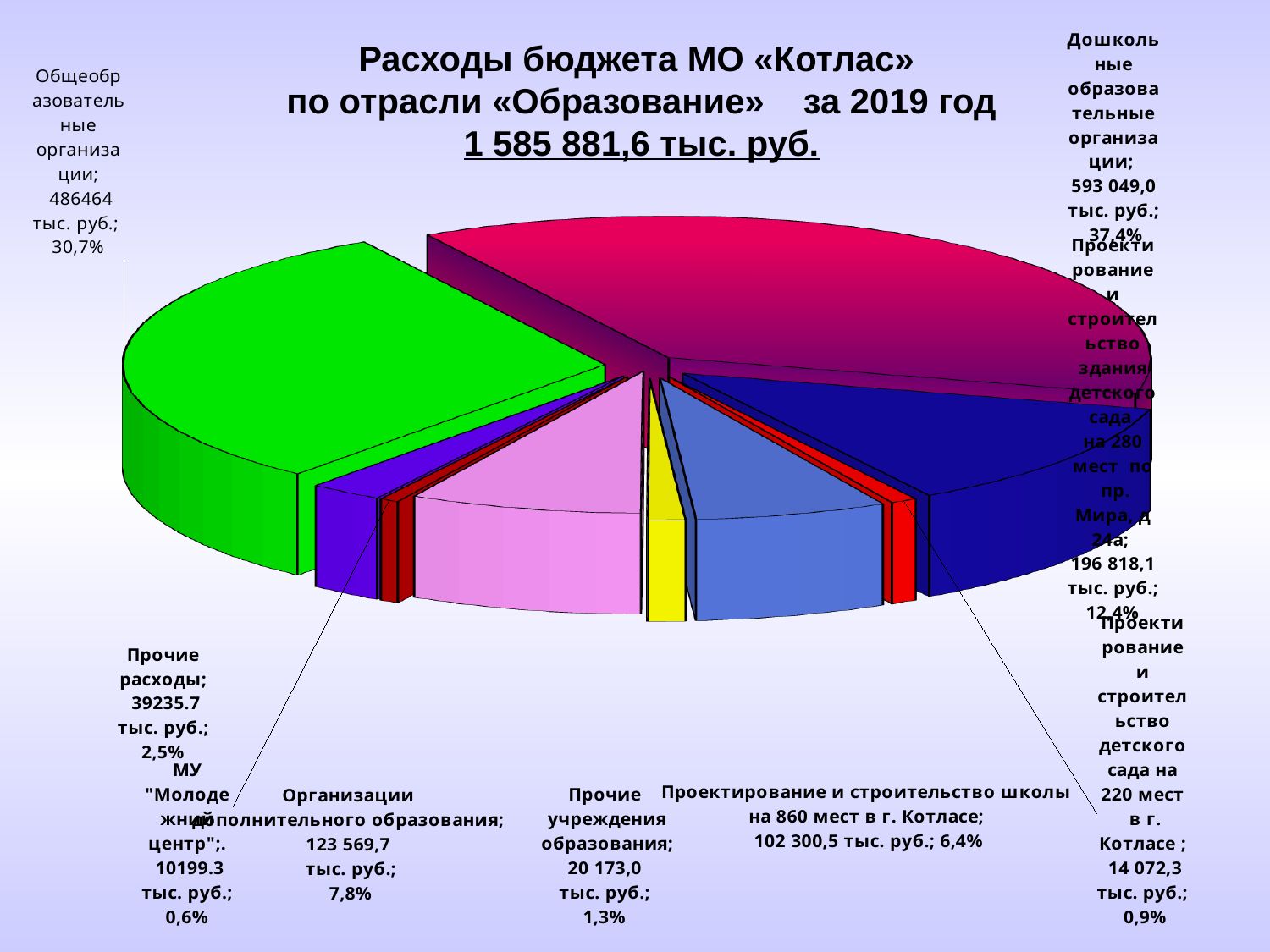
What share of the pie does «Общеобразовательные организации» represent? 30,7% What total amount is stated in the chart title? 1 585 881,6 тыс. руб. What is the value for «Организации дополнительного образования»? 123 569,7 тыс. руб. What is the difference in percentage points between «Дошкольные образовательные организации» (37,4%) and «Общеобразовательные организации» (30,7%)? 6,7 Which category has the smallest share of the pie? МУ "Молодежний центр" What kind of chart is shown on the slide? pie chart Which is larger: the share for «Прочие расходы» or the share for «Прочие учреждения образования»? Прочие расходы How many slices does the pie chart have? 9 What percentage is shown for «Проектирование и строительство школы на 860 мест в г. Котласе»? 6,4% Which category has the largest share of the pie? Дошкольные образовательные организации What is the value for «Дошкольные образовательные организации»? 593 049,0 тыс. руб. What is the value for «Проектирование и строительство детского сада на 220 мест в г. Котласе»? 14 072,3 тыс. руб.